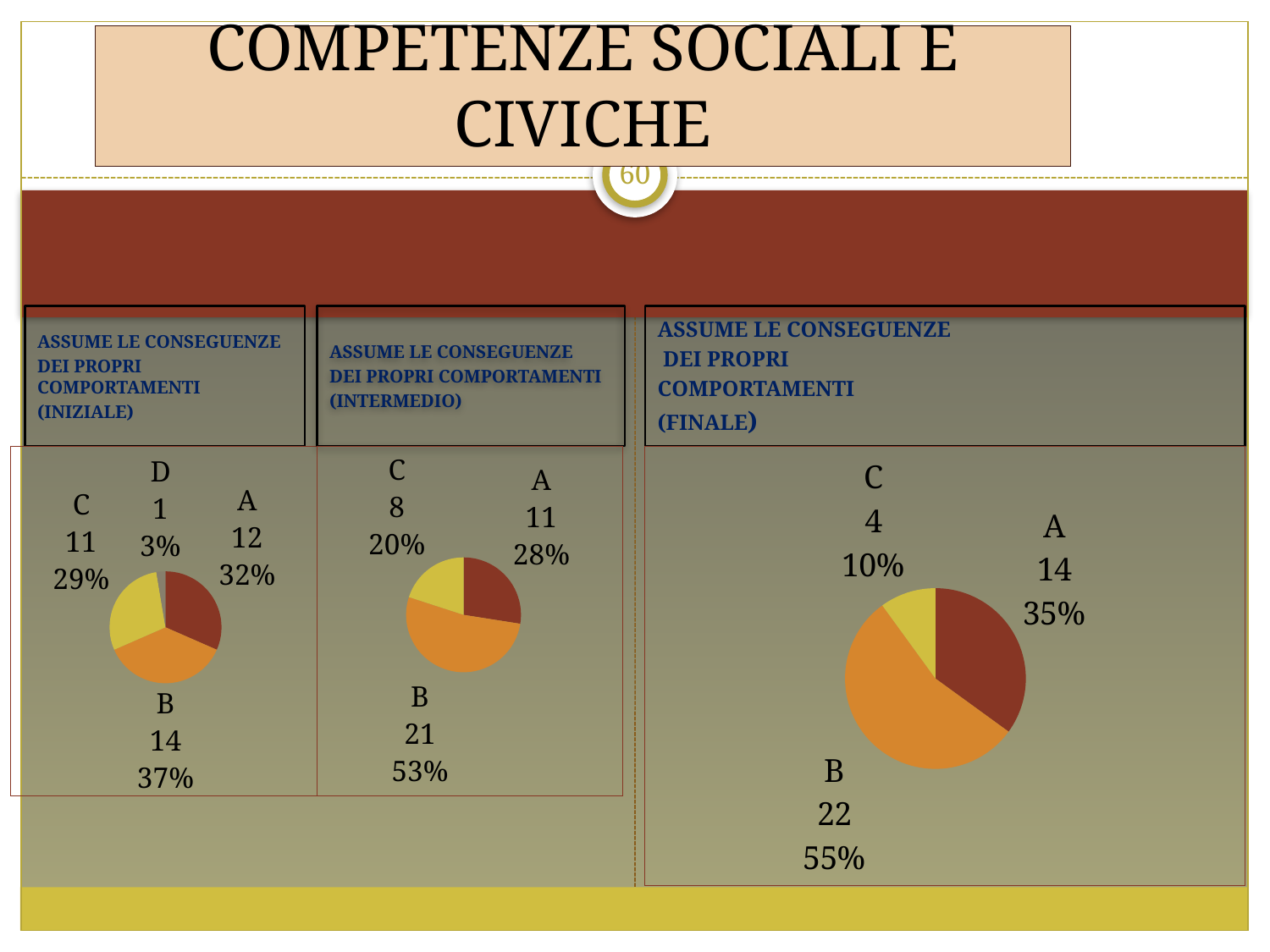
How many categories does the FINALE pie chart show? 3 In the INTERMEDIO pie chart, which category has the highest value? B In the FINALE pie chart, what is the value for category C? 4 How many categories does the INIZIALE pie chart show? 4 In the INIZIALE pie chart, which category has the lowest value? D In the INTERMEDIO pie chart, what is the difference between the values for B and A? 10 In the INIZIALE pie chart, what percentage share does category D have? 3% In the FINALE pie chart, what percentage share does category B have? 55% In the INTERMEDIO pie chart, what is the value for category C? 8 What type of chart is used in the FINALE panel? Pie chart In the INIZIALE pie chart, what is the value for category B? 14 In the FINALE pie chart, which is larger, the value for A or the value for C? A